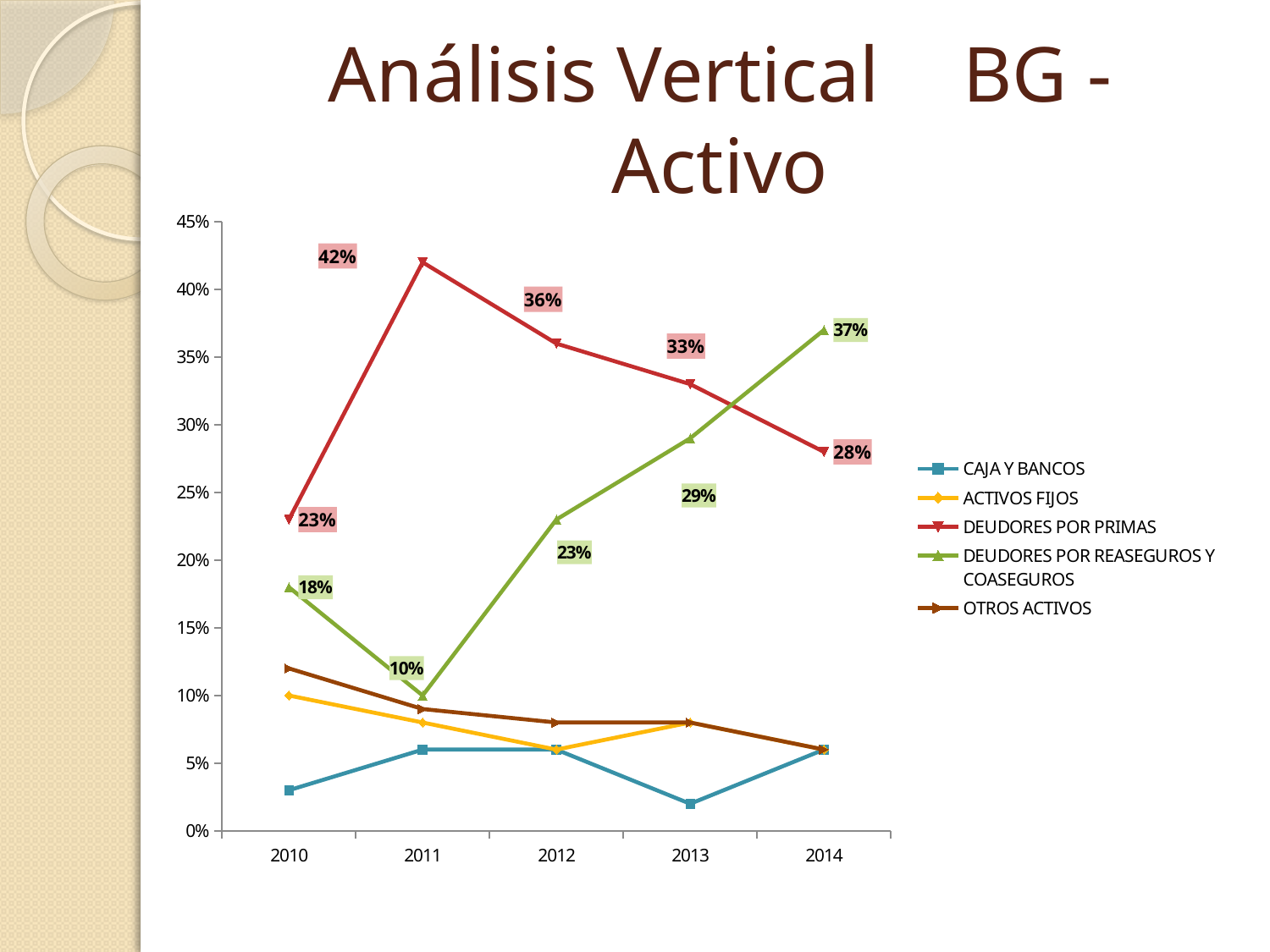
Is the value for OTROS ACTIVOS in 2010 greater or less than 10%? greater Does DEUDORES POR REASEGUROS Y COASEGUROS rise or fall from 2011 to 2014? rise How many series does the legend list? 5 How many years are shown on the x axis? 5 Which is larger in 2014, DEUDORES POR PRIMAS or DEUDORES POR REASEGUROS Y COASEGUROS? DEUDORES POR REASEGUROS Y COASEGUROS In which year is DEUDORES POR REASEGUROS Y COASEGUROS at its lowest value? 2011 What type of chart is shown on the slide? line chart In which year does DEUDORES POR PRIMAS reach its highest value? 2011 What is the difference between DEUDORES POR PRIMAS in 2011 and in 2014? 14% What is the value for DEUDORES POR PRIMAS in 2011? 42% What is the value for DEUDORES POR REASEGUROS Y COASEGUROS in 2014? 37% What is the value for DEUDORES POR REASEGUROS Y COASEGUROS in 2011? 10%